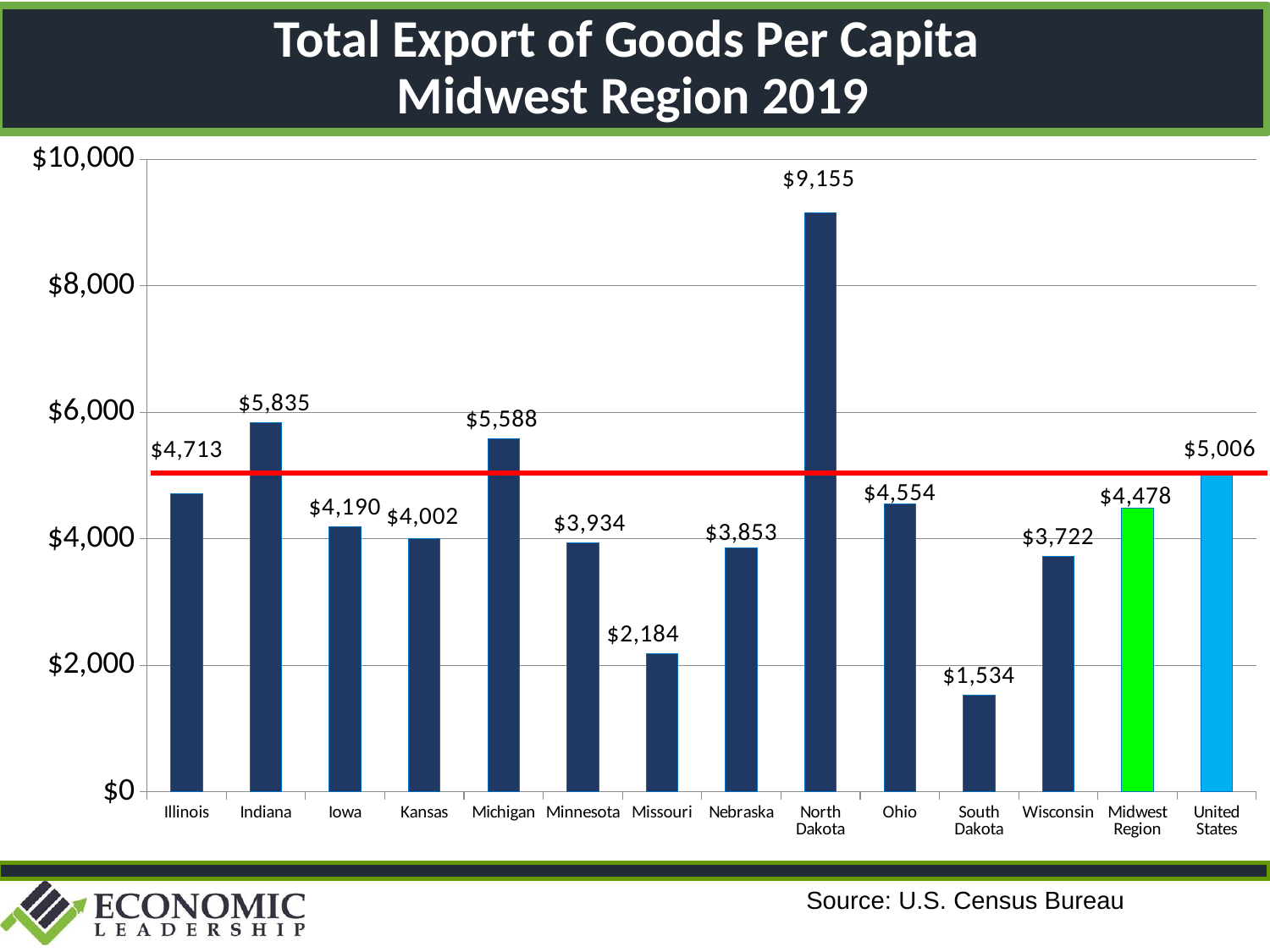
Which category has the highest export of goods per capita? North Dakota What is the value shown for the United States? $5,006 What colour is the bar for the Midwest Region? Green What is the difference between Indiana's and Illinois's values? $1,122 How many categories are shown on the x axis? 14 Which is larger, the value for Ohio or the value for Wisconsin? Ohio Which category has the lowest export of goods per capita? South Dakota What is the difference between the United States value and the Midwest Region value? $528 What is the value shown for the Midwest Region? $4,478 Is the value for Missouri greater or less than $4,000? less What kind of chart is shown on the slide? Bar chart What is the total export of goods per capita for North Dakota? $9,155